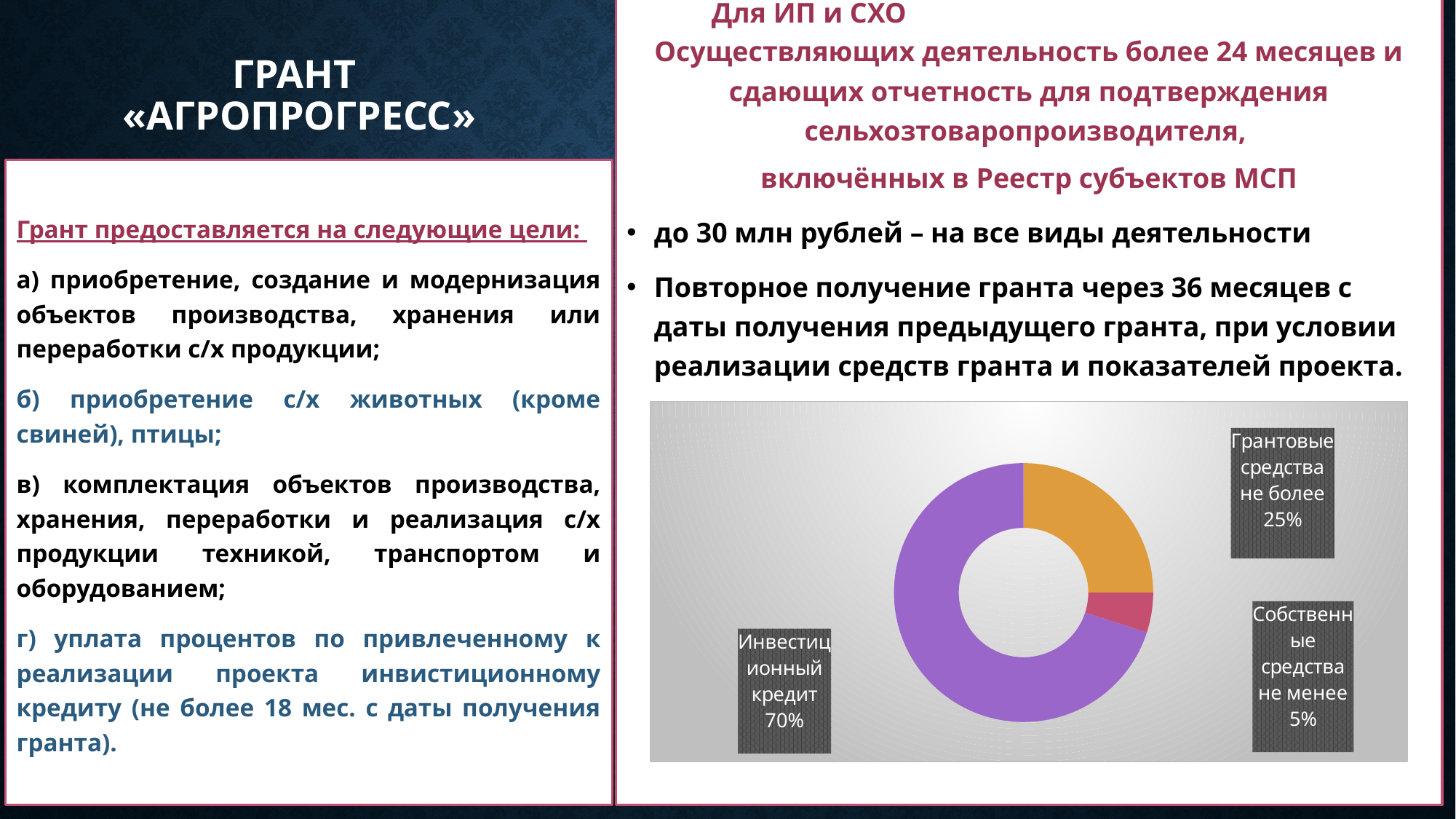
What is the difference between the share for "Грантовые средства" and the share for "Собственные средства"? 20% What share of the chart is labelled "Инвестиционный кредит"? 70% What percentage is shown for "Грантовые средства"? не более 25% What is the difference between the share for "Инвестиционный кредит" and the share for "Грантовые средства"? 45% What kind of chart is shown on the slide? Doughnut (pie) chart How many slices does the doughnut chart have? 3 Which slice of the chart is the smallest? Собственные средства Which is larger: the share for "Грантовые средства" or the share for "Собственные средства"? Грантовые средства Which slice of the chart is the largest? Инвестиционный кредит What colour is the slice for "Инвестиционный кредит"? Purple What percentage is shown for "Собственные средства"? не менее 5% What colour is the slice for "Грантовые средства"? Orange